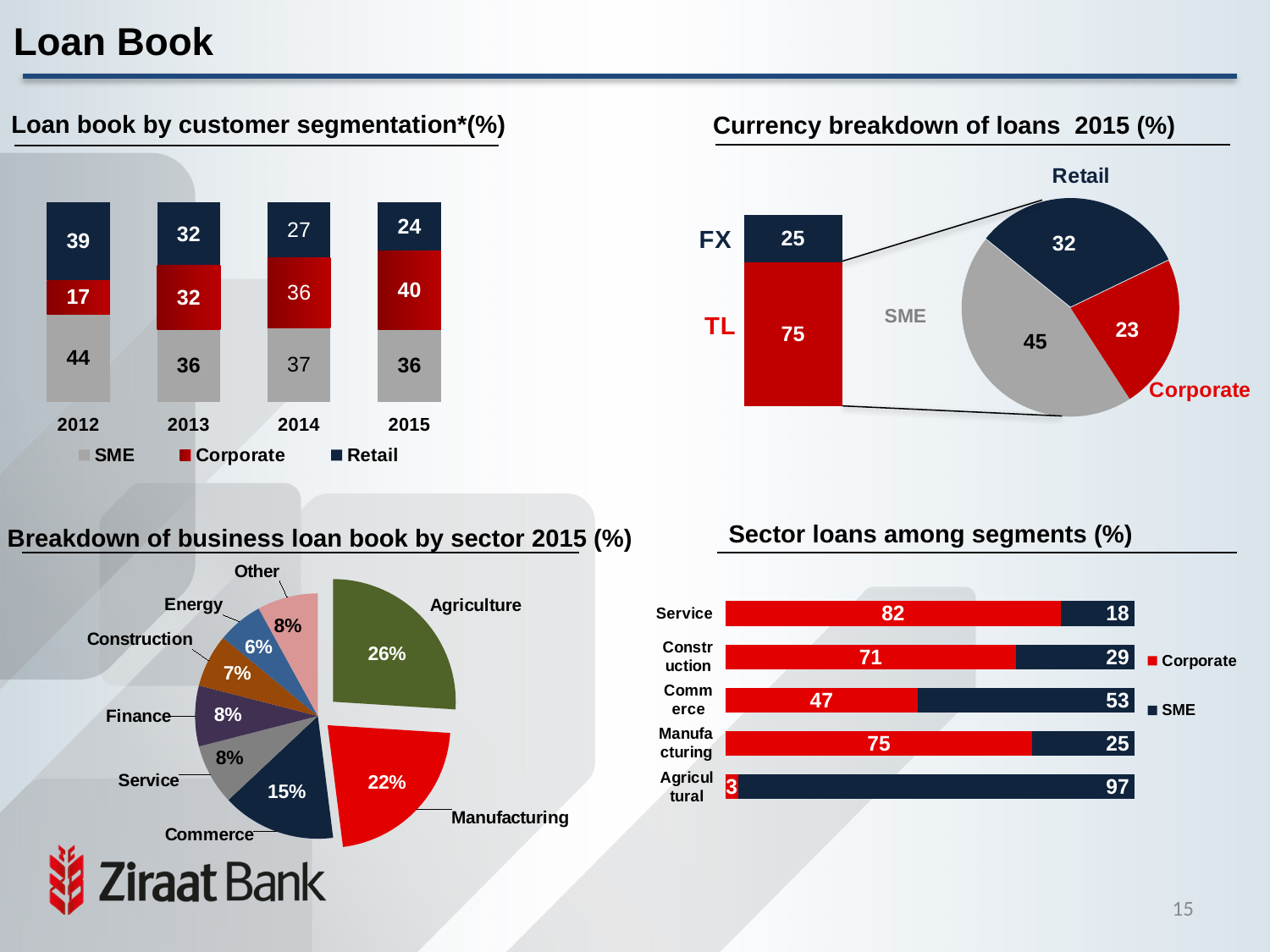
In the 'Currency breakdown of loans 2015' pie, which segment is the smallest? Corporate In the 'Breakdown of business loan book by sector 2015' chart, which sector has the largest share? Agriculture In the 'Loan book by customer segmentation' chart, how many series does the legend list? 3 In the 'Currency breakdown of loans 2015' chart, what is the TL share? 75 In the 'Loan book by customer segmentation' chart, how much did the Corporate share change from 2012 to 2015? 23 In the 'Loan book by customer segmentation' chart, does the Retail share rise or fall from 2012 to 2015? fall In the 'Sector loans among segments' chart, what is the Corporate value for Commerce? 47 In the 'Loan book by customer segmentation' chart, what is the SME value for 2012? 44 In the 'Loan book by customer segmentation' chart, what is the Corporate value for 2015? 40 In the 'Currency breakdown of loans 2015' chart, what is the SME share in the pie? 45 In the 'Breakdown of business loan book by sector 2015' chart, what is the share for Manufacturing? 22% In the 'Sector loans among segments' chart, which sector has the highest SME value? Agricultural